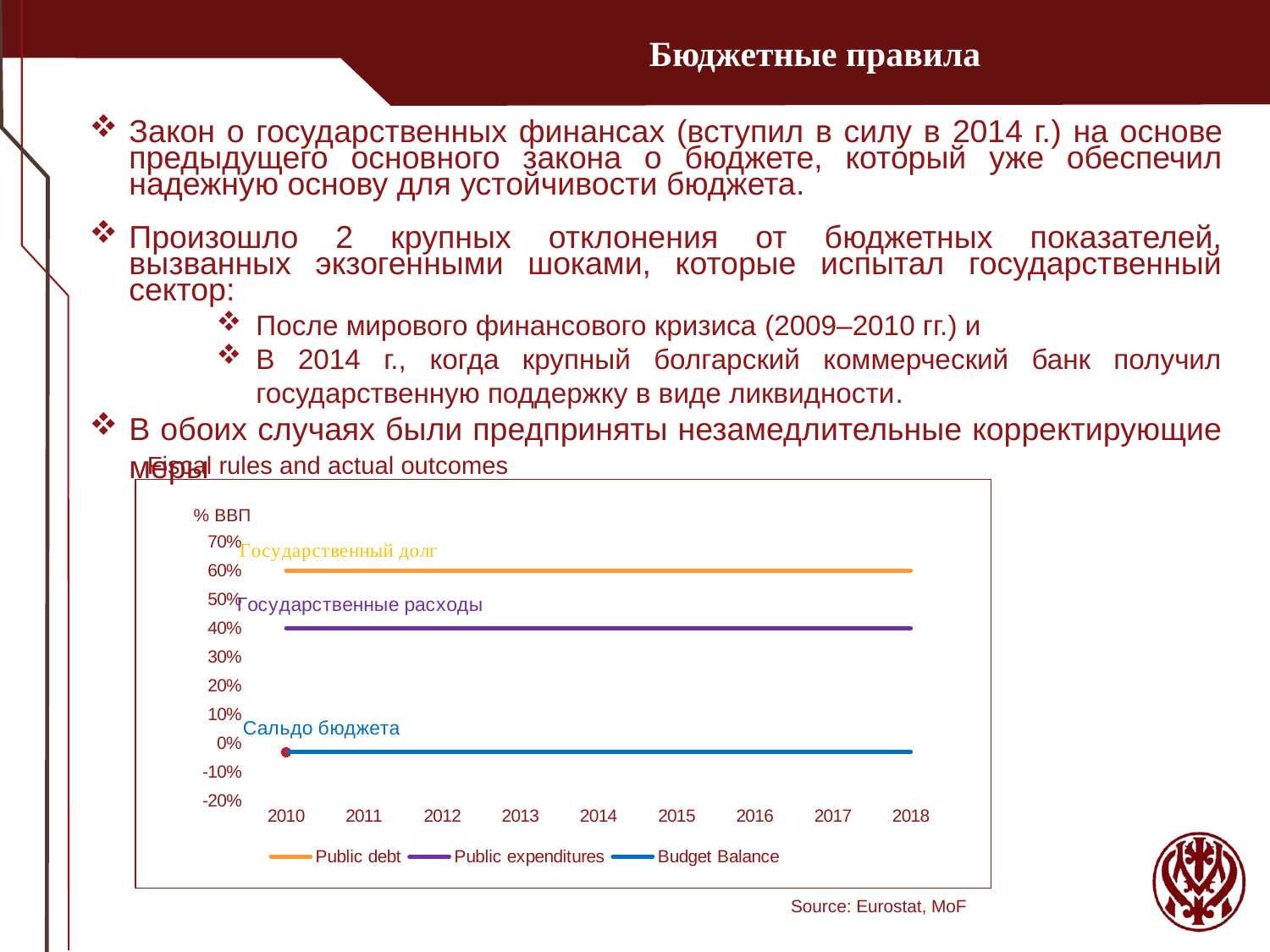
Which series has the highest values in the chart? Public debt How many series does the chart legend list? 3 Is the value for Public expenditures greater or less than 50%? less Which is larger in the chart, Public debt or Public expenditures? Public debt What kind of chart is shown on the slide? Line chart Is the value for Budget Balance greater or less than 10%? less Does the Public debt line rise, fall or stay flat from 2010 to 2018? Stays flat How many years are shown on the x axis of the chart? 9 Is the value for Public debt greater or less than 50%? greater What colour is the Public debt line in the chart? Orange What is the title of the chart? Fiscal rules and actual outcomes Which series has the lowest values in the chart? Budget Balance